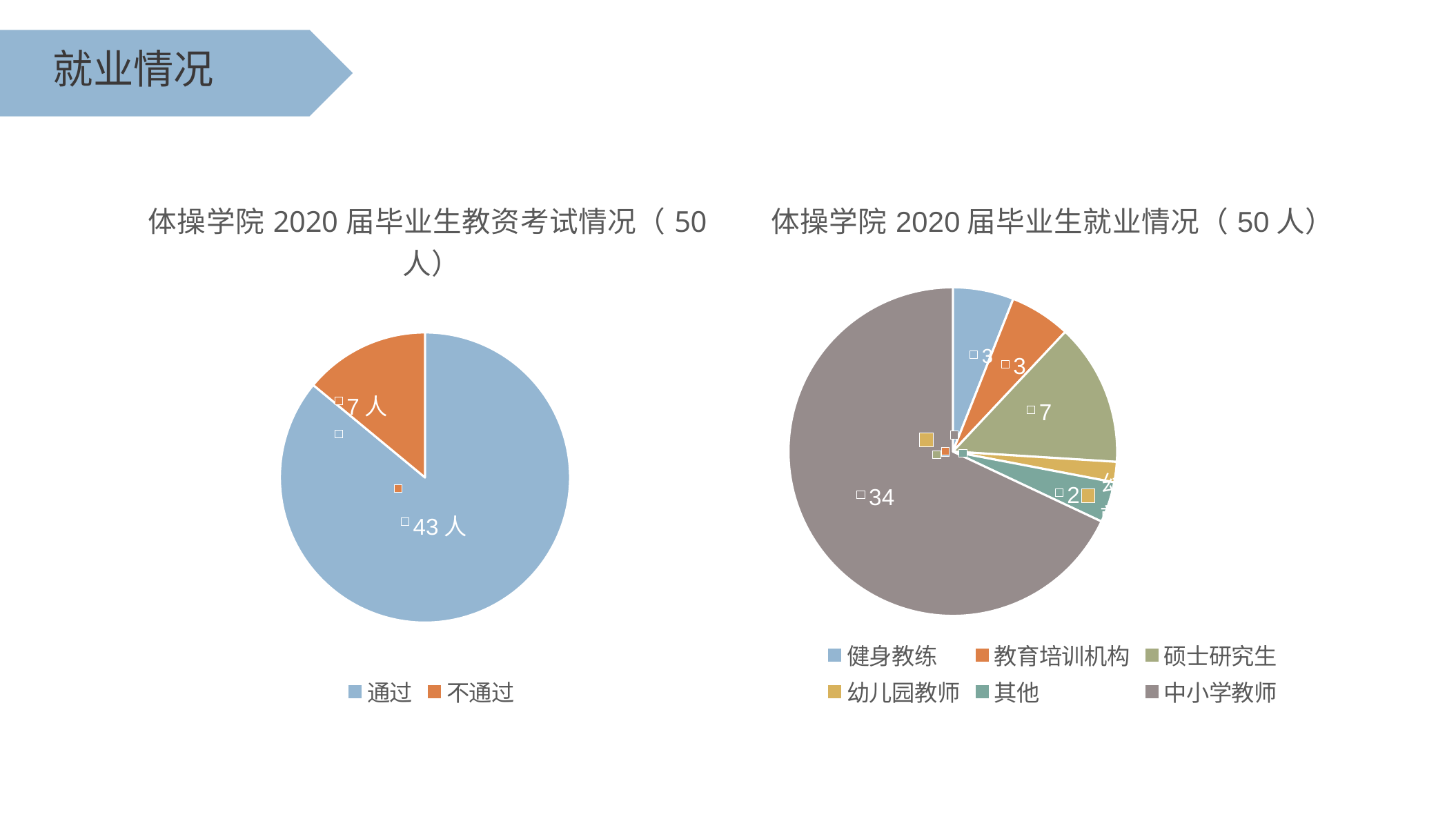
In the right chart (体操学院 2020 届毕业生就业情况), what is the difference between 中小学教师 and 硕士研究生? 27 In the right chart (体操学院 2020 届毕业生就业情况), what is the value for 其他? 2 In the right chart (体操学院 2020 届毕业生就业情况), which is larger, 硕士研究生 or 健身教练? 硕士研究生 In the left chart (体操学院 2020 届毕业生教资考试情况), what share of the pie does 不通过 represent? 14% In the left chart (体操学院 2020 届毕业生教资考试情况), what is the value for 通过? 43 人 In the left chart (体操学院 2020 届毕业生教资考试情况), what is the value for 不通过? 7 人 In the right chart (体操学院 2020 届毕业生就业情况), which category is the largest? 中小学教师 In the right chart (体操学院 2020 届毕业生就业情况), how many categories does the legend list? 6 In the left chart (体操学院 2020 届毕业生教资考试情况), what is the difference between 通过 and 不通过? 36 人 In the right chart (体操学院 2020 届毕业生就业情况), what is the value for 硕士研究生? 7 What kind of chart is the left chart (体操学院 2020 届毕业生教资考试情况)? pie chart In the right chart (体操学院 2020 届毕业生就业情况), what is the value for 中小学教师? 34